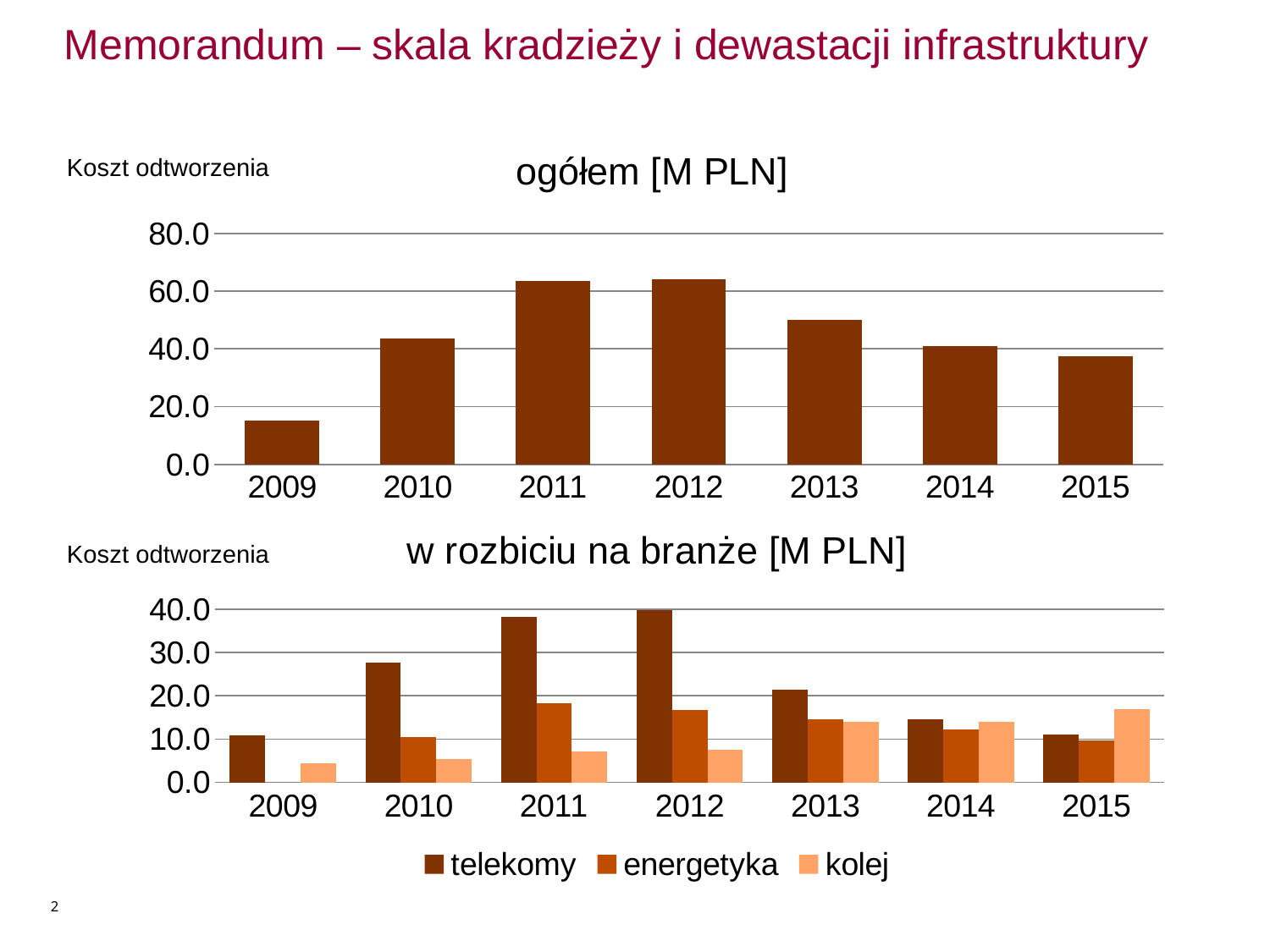
In the bottom chart 'w rozbiciu na branże [M PLN]', which series has the highest value in 2012? telekomy In the top chart 'ogółem [M PLN]', which is larger, the value for 2013 or the value for 2015? 2013 What kind of chart is the top chart titled 'ogółem [M PLN]'? bar chart What is the title of the bottom chart on the slide? w rozbiciu na branże [M PLN] How many years are shown on the x axis of the top chart 'ogółem [M PLN]'? 7 In the top chart 'ogółem [M PLN]', do the values rise or fall from 2012 to 2015? fall In the bottom chart 'w rozbiciu na branże [M PLN]', which series has the highest value in 2015? kolej In the top chart 'ogółem [M PLN]', is the value for 2011 greater or less than 60.0? greater In the top chart 'ogółem [M PLN]', which year has the lowest value? 2009 How many series does the legend of the bottom chart 'w rozbiciu na branże [M PLN]' list? 3 In the top chart 'ogółem [M PLN]', is the value for 2009 greater or less than 20.0? less In the bottom chart 'w rozbiciu na branże [M PLN]', is the value for telekomy in 2011 greater or less than 30.0? greater